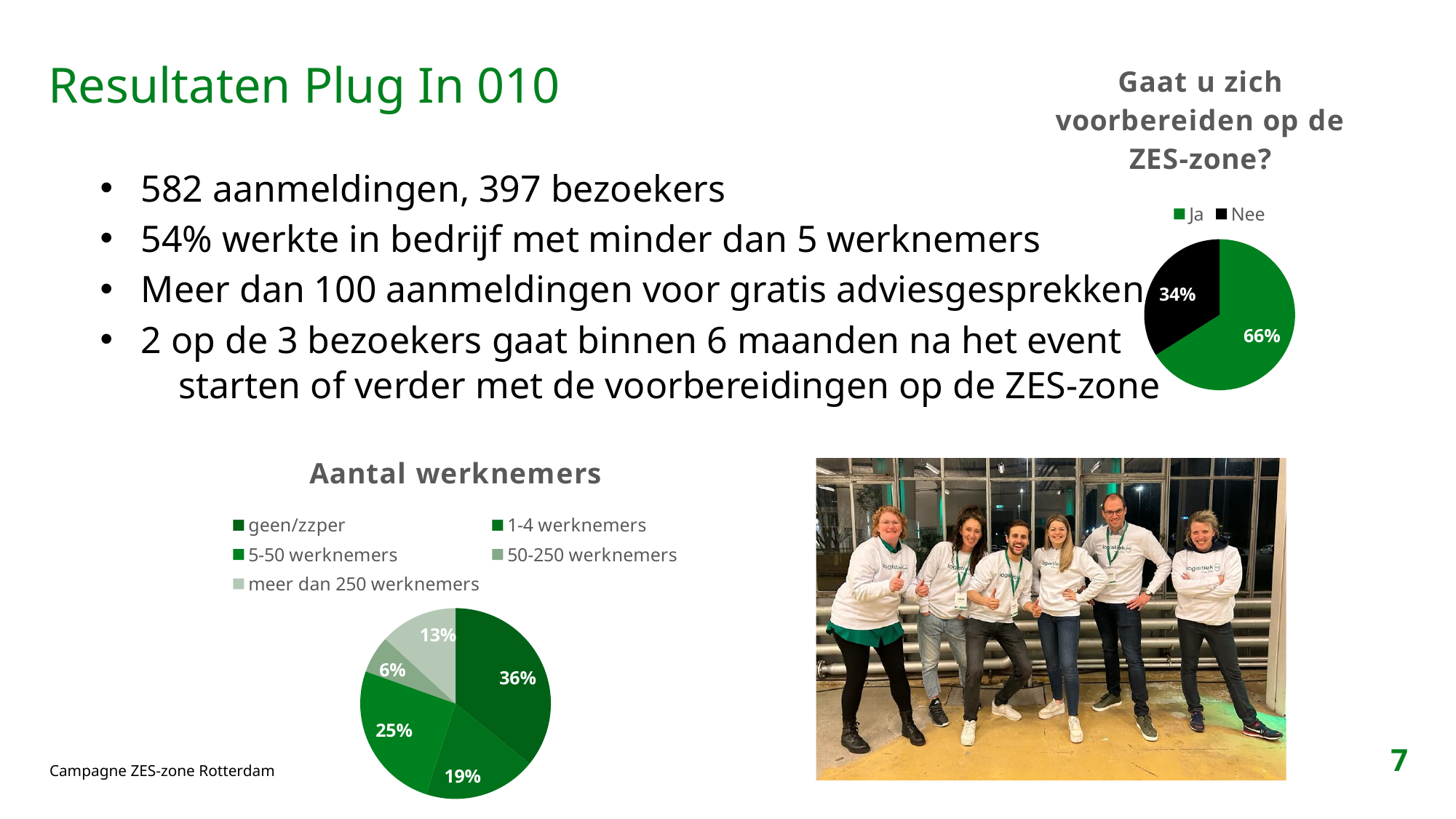
In the 'Gaat u zich voorbereiden op de ZES-zone?' chart, what share of respondents answered 'Ja'? 66% In the 'Gaat u zich voorbereiden op de ZES-zone?' chart, what is the difference in percentage points between 'Ja' and 'Nee'? 32 percentage points In the 'Aantal werknemers' chart, what share is '5-50 werknemers'? 25% In the 'Aantal werknemers' chart, which category has the largest share? geen/zzper In the 'Gaat u zich voorbereiden op de ZES-zone?' chart, what share of respondents answered 'Nee'? 34% In the 'Aantal werknemers' chart, how many categories are shown? 5 In the 'Aantal werknemers' chart, which category has the smallest share? 50-250 werknemers How many categories does the legend of the 'Gaat u zich voorbereiden op de ZES-zone?' chart list? 2 In the 'Aantal werknemers' chart, which is larger: '5-50 werknemers' or 'meer dan 250 werknemers'? 5-50 werknemers What kind of chart is the 'Gaat u zich voorbereiden op de ZES-zone?' chart? Pie chart